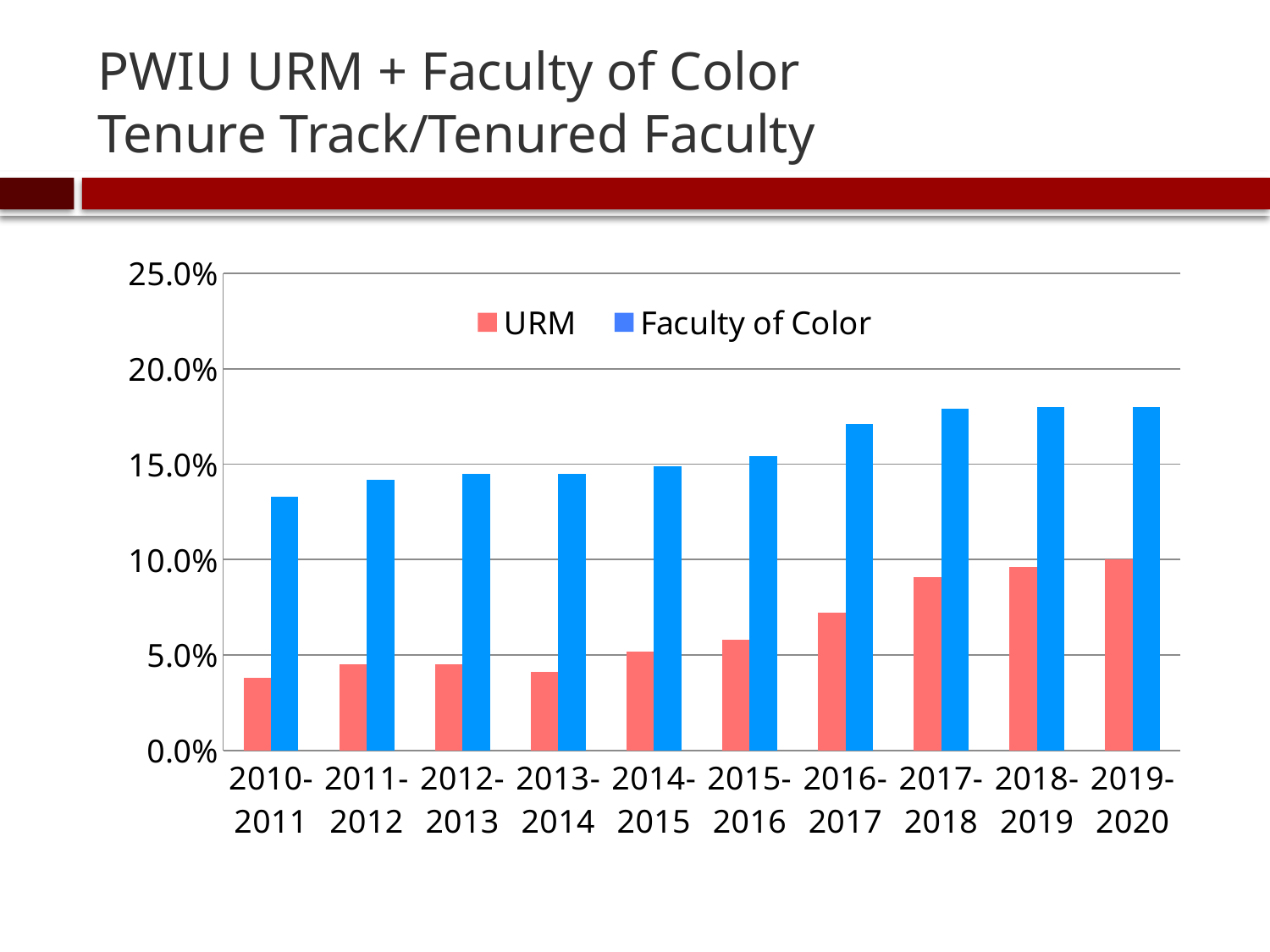
Which academic year has the highest URM value? 2019-2020 Is the Faculty of Color value for 2019-2020 greater or less than 15.0%? greater Is the URM value for 2010-2011 greater or less than 5.0%? less Is the URM value for 2016-2017 greater or less than 5.0%? greater Do the Faculty of Color values generally rise or fall from 2010-2011 to 2019-2020? rise How many academic-year categories are shown on the x axis? 10 For 2016-2017, which is larger: the URM value or the Faculty of Color value? Faculty of Color Which academic year has the lowest Faculty of Color value? 2010-2011 Which series does the legend list first? URM What kind of chart is shown on the slide? bar chart How many series does the legend list? 2